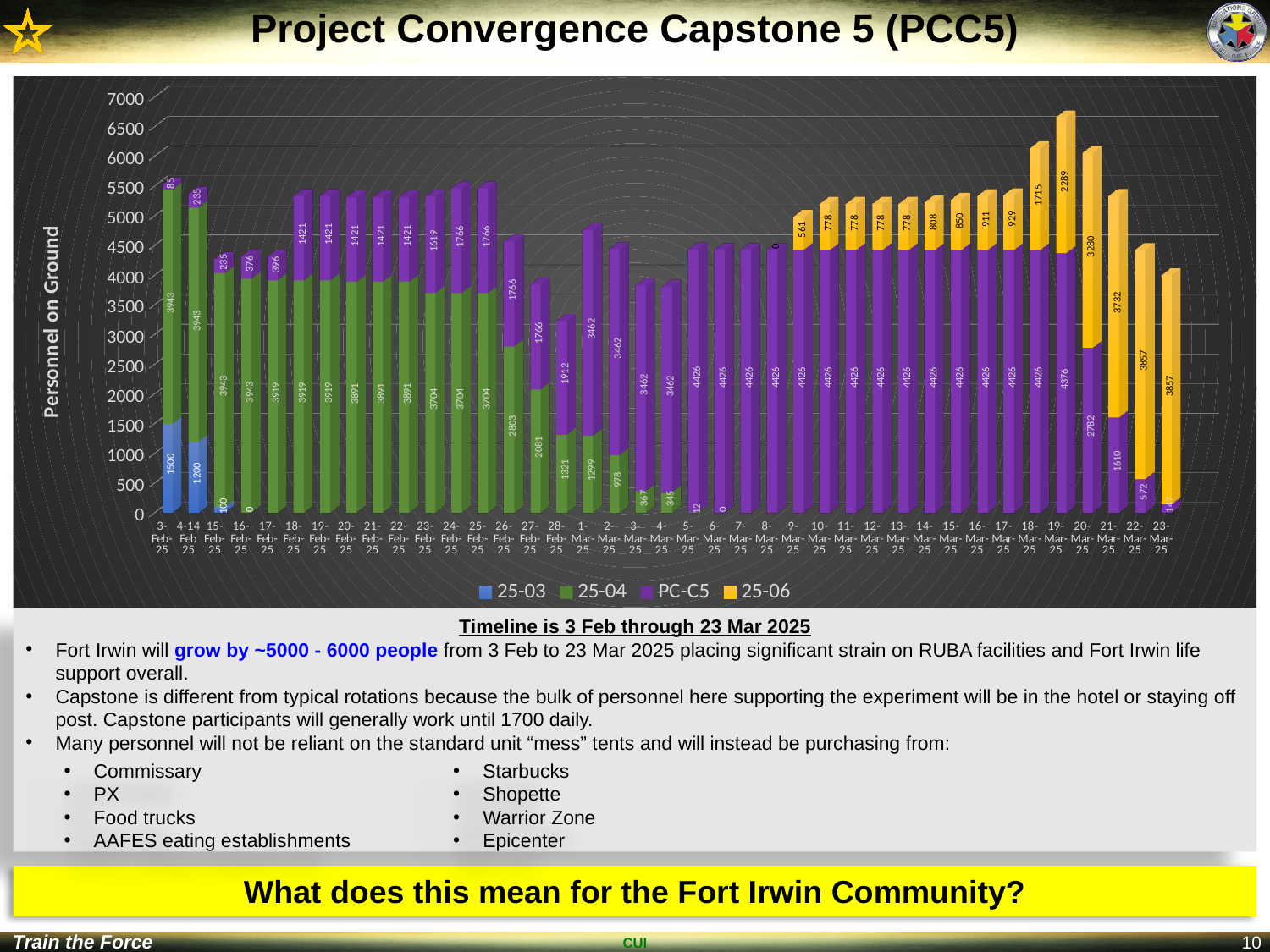
How many series does the chart legend list? 4 What is the total of the stacked bar for 20-Mar-25? 6062 Which is larger, the 25-04 value on 27-Feb-25 or on 28-Feb-25? 27-Feb-25 What is the 25-03 value on 3-Feb-25? 1500 What is the difference between the 25-06 values on 18-Mar-25 and 17-Mar-25? 786 What is the 25-04 value on 2-Mar-25? 978 What kind of chart is shown on the slide? bar chart What is the PC-C5 value on 1-Mar-25? 3462 What is the title of the vertical axis? Personnel on Ground Which date has the tallest total stacked bar? 19-Mar-25 What is the 25-06 value on 19-Mar-25? 2289 What is the 25-04 value on 26-Feb-25? 2803